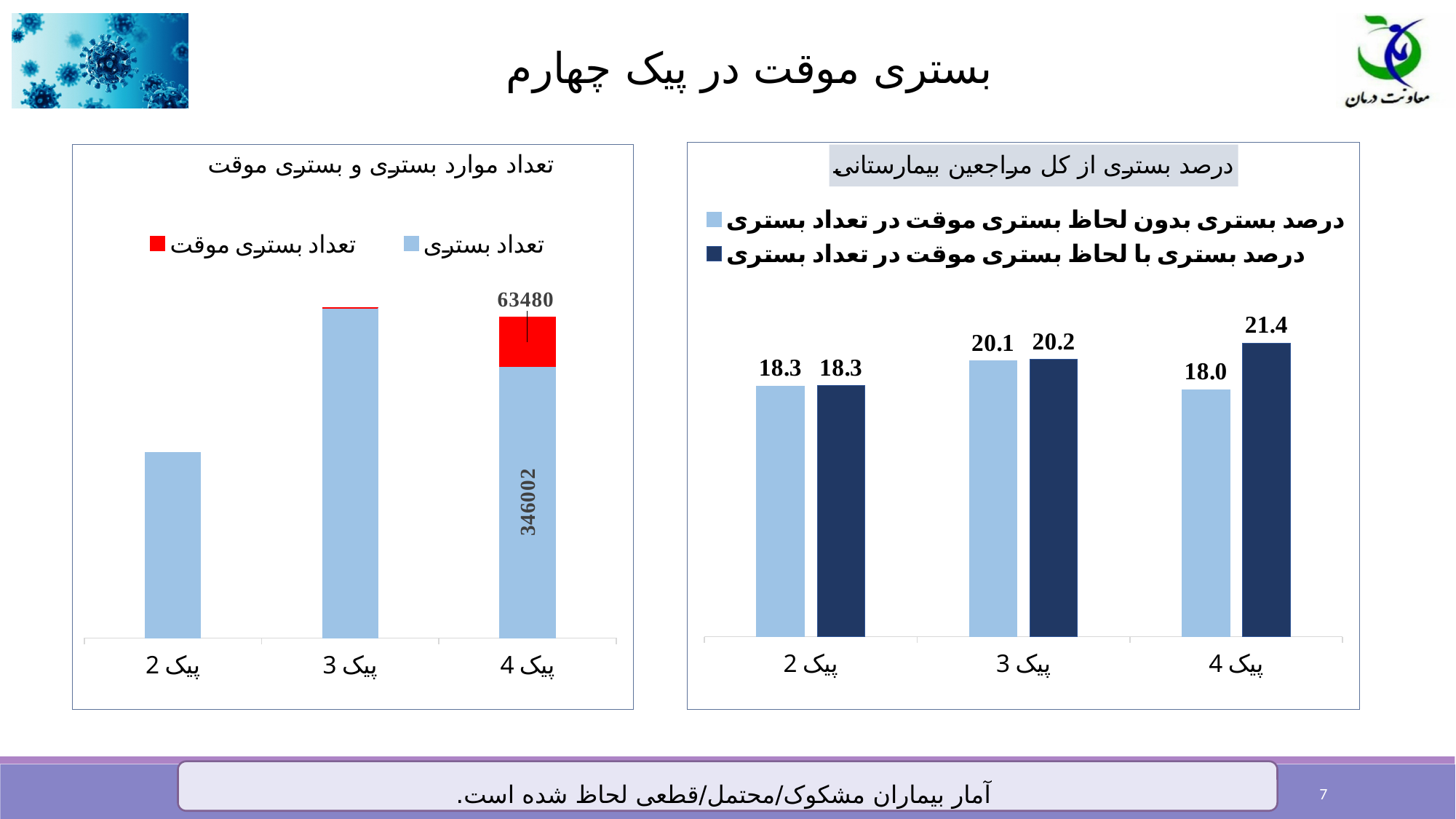
In the left chart (تعداد موارد بستری و بستری موقت), how many series does the legend list? 2 In the left chart (تعداد موارد بستری و بستری موقت), which peak has the lowest total? پیک 2 In the right chart (درصد بستری از کل مراجعین بیمارستانی), how many peaks are shown on the x axis? 3 What kind of chart is the right chart (درصد بستری از کل مراجعین بیمارستانی)? bar chart In the right chart (درصد بستری از کل مراجعین بیمارستانی), what is the value of درصد بستری بدون لحاظ بستری موقت در تعداد بستری for پیک 3? 20.1 In the left chart (تعداد موارد بستری و بستری موقت), which is larger, the bar for پیک 2 or the bar for پیک 3? پیک 3 In the left chart (تعداد موارد بستری و بستری موقت), what is the total of the stacked bar for پیک 4? 409482 In the right chart (درصد بستری از کل مراجعین بیمارستانی), what is the value of درصد بستری با لحاظ بستری موقت در تعداد بستری for پیک 4? 21.4 In the left chart (تعداد موارد بستری و بستری موقت), what is the value of تعداد بستری موقت for پیک 4? 63480 In the right chart (درصد بستری از کل مراجعین بیمارستانی), which peak has the highest value for درصد بستری با لحاظ بستری موقت در تعداد بستری? پیک 4 In the left chart (تعداد موارد بستری و بستری موقت), what is the value of تعداد بستری for پیک 4? 346002 In the right chart (درصد بستری از کل مراجعین بیمارستانی), what is the difference between the two series for پیک 4? 3.4